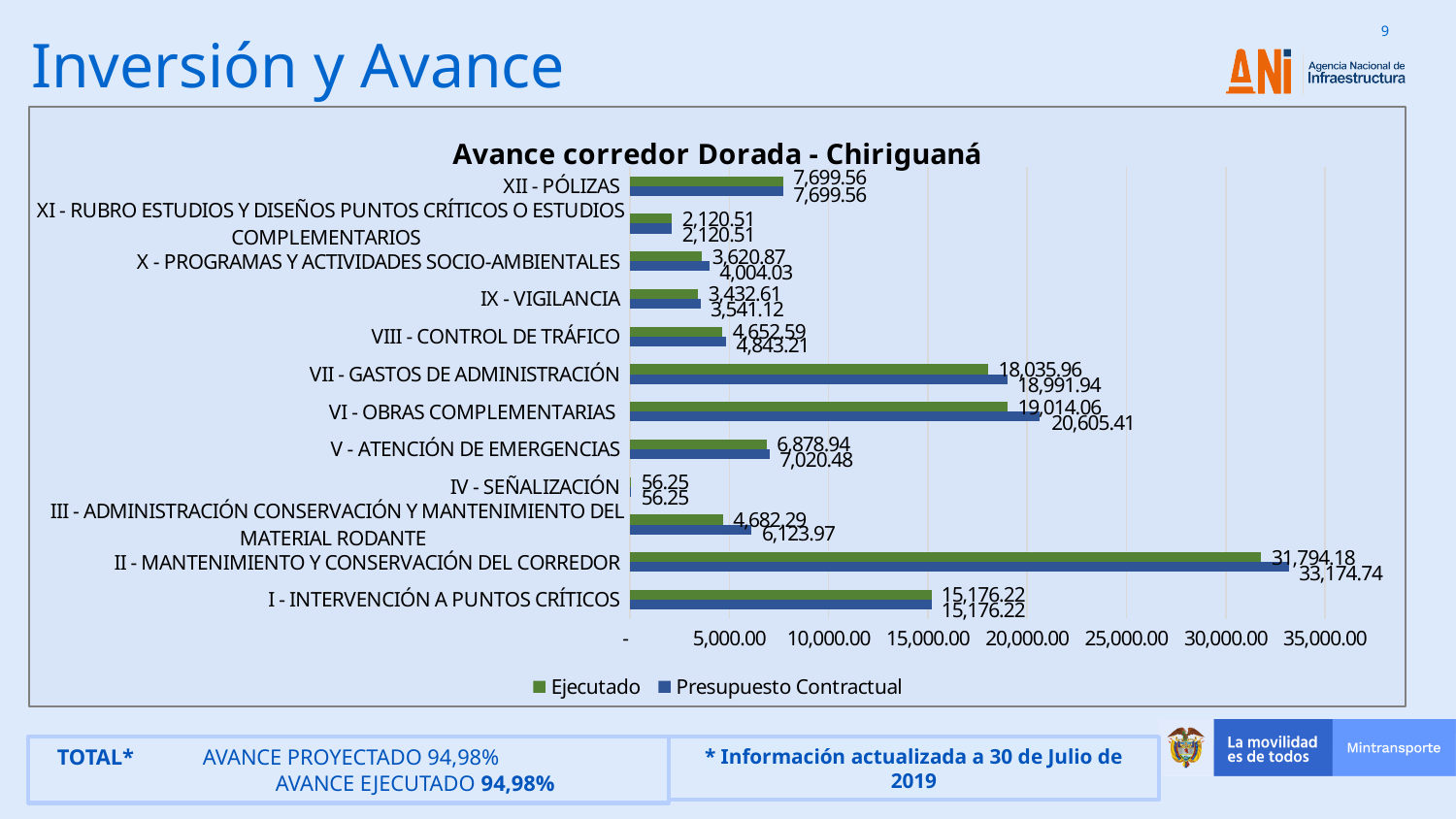
What type of chart is shown on the slide? Bar chart Which category has the lowest Ejecutado value? IV - SEÑALIZACIÓN What is the Ejecutado value for I - INTERVENCIÓN A PUNTOS CRÍTICOS? 15,176.22 What is the Ejecutado value for VII - GASTOS DE ADMINISTRACIÓN? 18,035.96 Which series is shown in green in the chart? Ejecutado How many series does the legend list? 2 Which is larger for III - ADMINISTRACIÓN CONSERVACIÓN Y MANTENIMIENTO DEL MATERIAL RODANTE: the Ejecutado value or the Presupuesto Contractual value? Presupuesto Contractual Which category has the highest Presupuesto Contractual value? II - MANTENIMIENTO Y CONSERVACIÓN DEL CORREDOR How many categories are plotted in the chart? 12 What is the Presupuesto Contractual value for VI - OBRAS COMPLEMENTARIAS? 20,605.41 What is the difference between the Presupuesto Contractual and Ejecutado values for II - MANTENIMIENTO Y CONSERVACIÓN DEL CORREDOR? 1,380.56 What is the title of the chart? Avance corredor Dorada - Chiriguaná